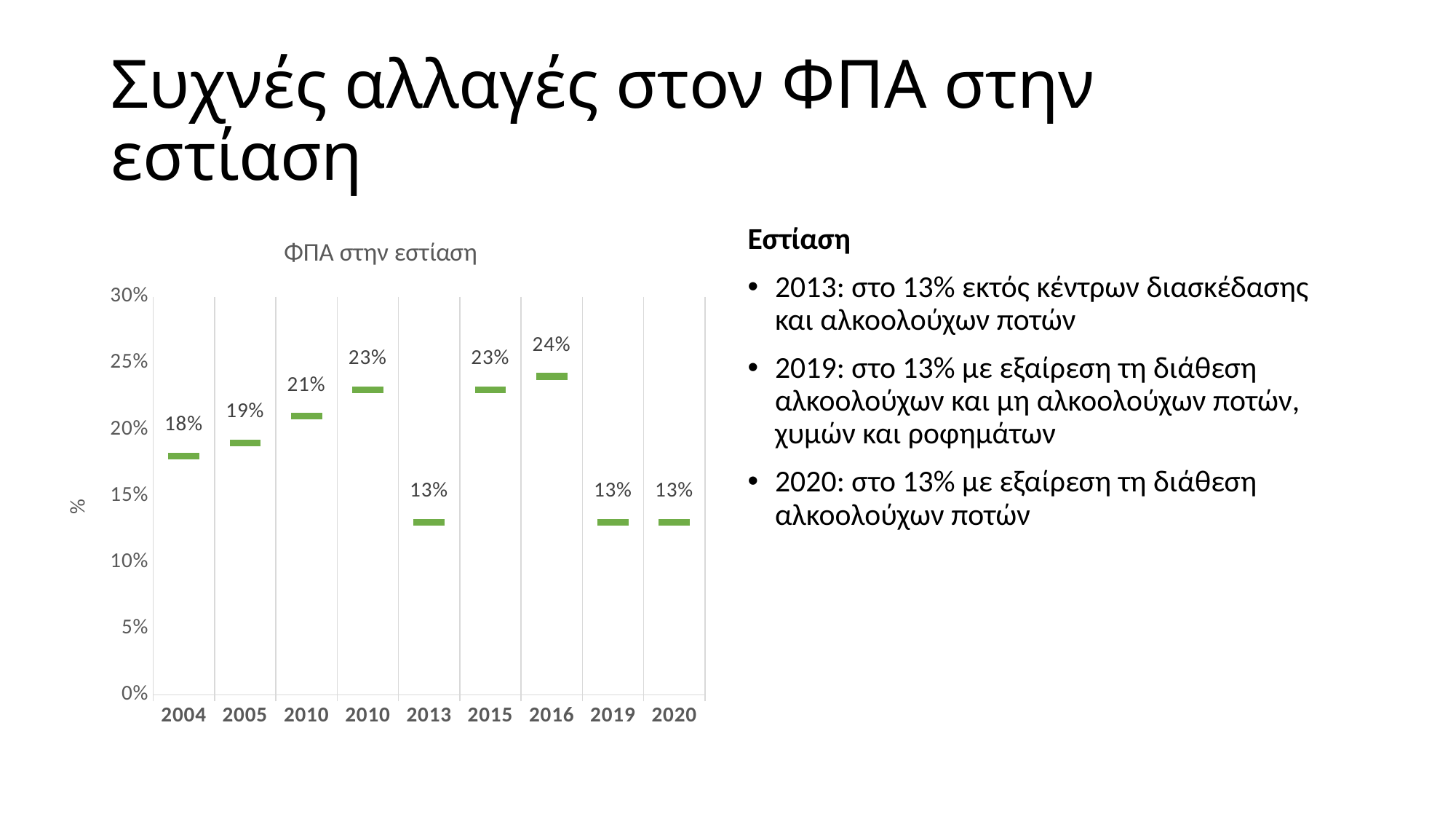
What is the lowest value shown in the chart? 13% What value does the chart show for 2016? 24% Between 2016 and 2019, does the value rise or fall? fall Is the value for 2004 greater or less than 20%? less How many data points are plotted in the chart? 9 What is the label on the vertical axis of the chart? % Which year has the highest value in the chart? 2016 Which is larger, the value for 2005 or the value for 2015? 2015 What is the difference between the value for 2016 and the value for 2004? 6 percentage points What is the title of the chart? ΦΠΑ στην εστίαση What is the value plotted for 2013? 13% What is the VAT rate shown for 2004 in the chart? 18%